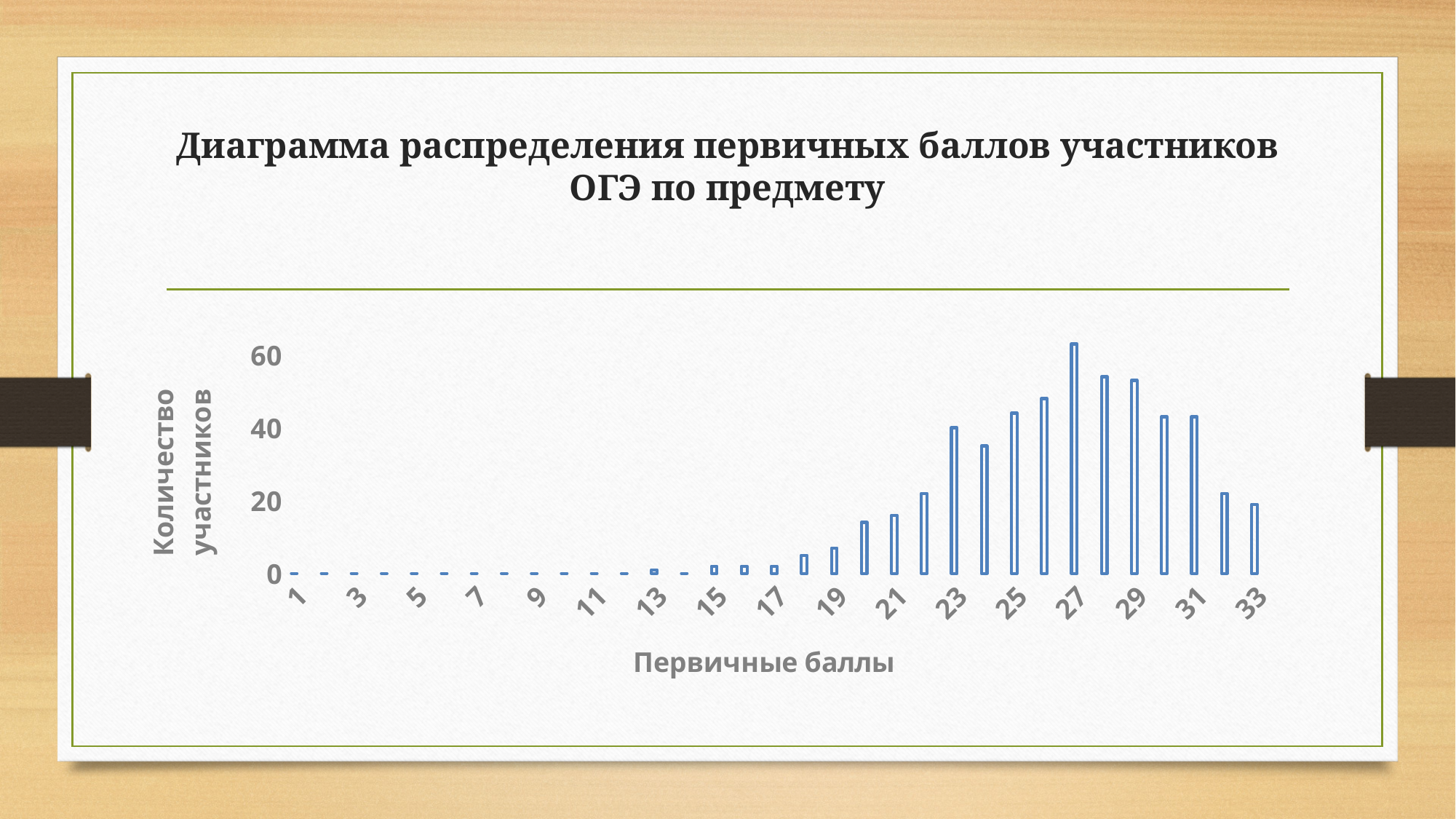
Which primary score has the highest number of participants? 27 Is the number of participants for primary score 27 greater or less than 60? greater Do the values rise or fall along the x axis from primary score 17 to primary score 27? rise What kind of chart is shown on the slide? bar chart Is the number of participants for primary score 19 greater or less than 20? less Is the number of participants for primary score 28 greater or less than 40? greater What is the title of the x axis? Первичные баллы Which has more participants: primary score 28 or primary score 32? 28 What is the title of the y axis? Количество участников Which has more participants: primary score 27 or primary score 23? 27